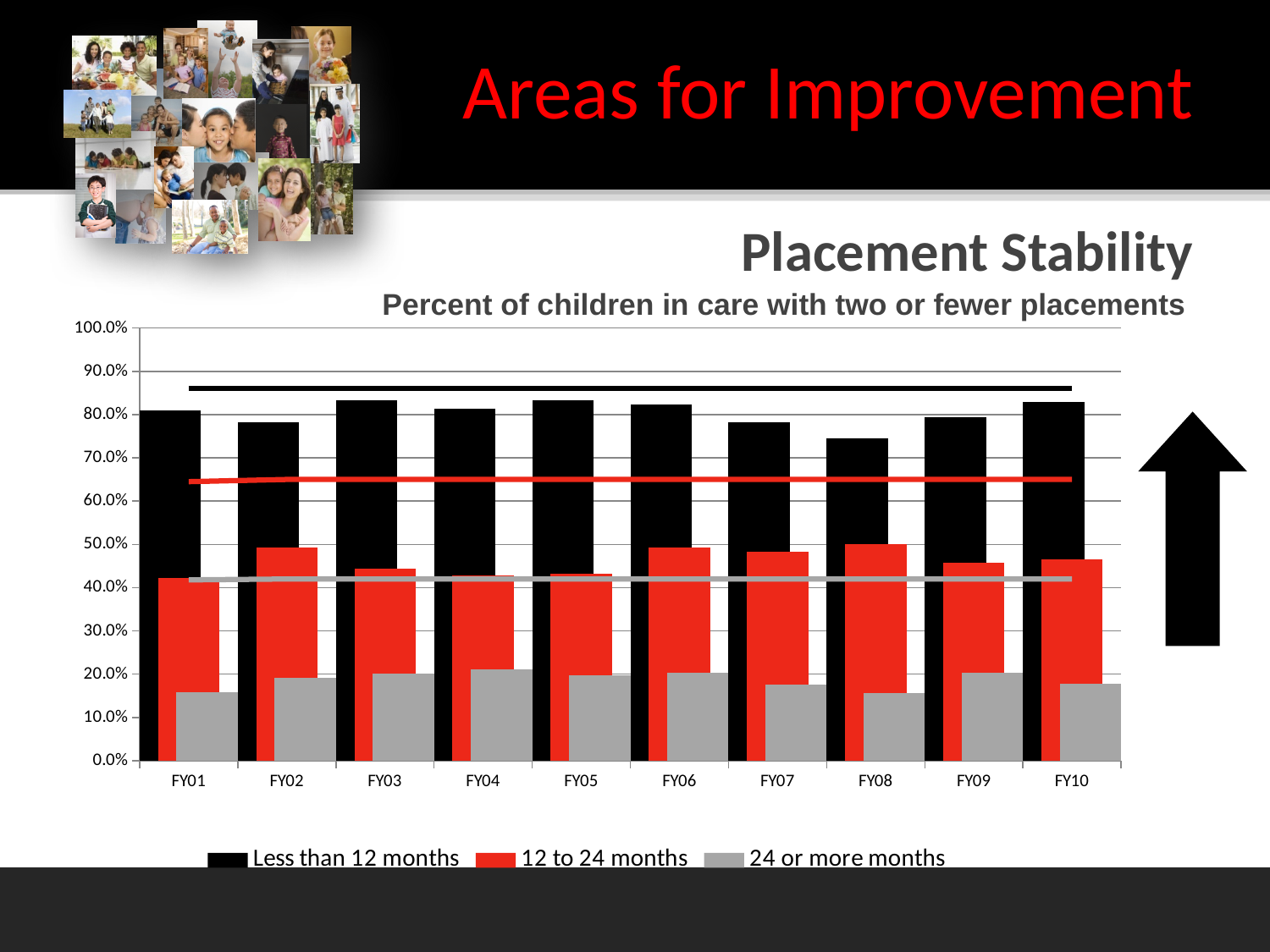
Is the '24 or more months' value for FY01 greater or less than 20.0%? less How many series does the chart's legend list? 3 Which fiscal year has the lowest value for the 'Less than 12 months' series? FY08 Is the 'Less than 12 months' value for FY03 greater or less than 80.0%? greater Which is larger: the '12 to 24 months' value for FY01 or for FY02? FY02 Which colour represents the '24 or more months' series in the chart? gray How many fiscal years are shown on the x axis of the chart? 10 Is the '12 to 24 months' value for FY02 greater or less than 40.0%? greater What kind of chart is shown on the slide? bar and line chart Which is larger: the 'Less than 12 months' value for FY03 or for FY08? FY03 What is the subtitle printed above the chart? Percent of children in care with two or fewer placements